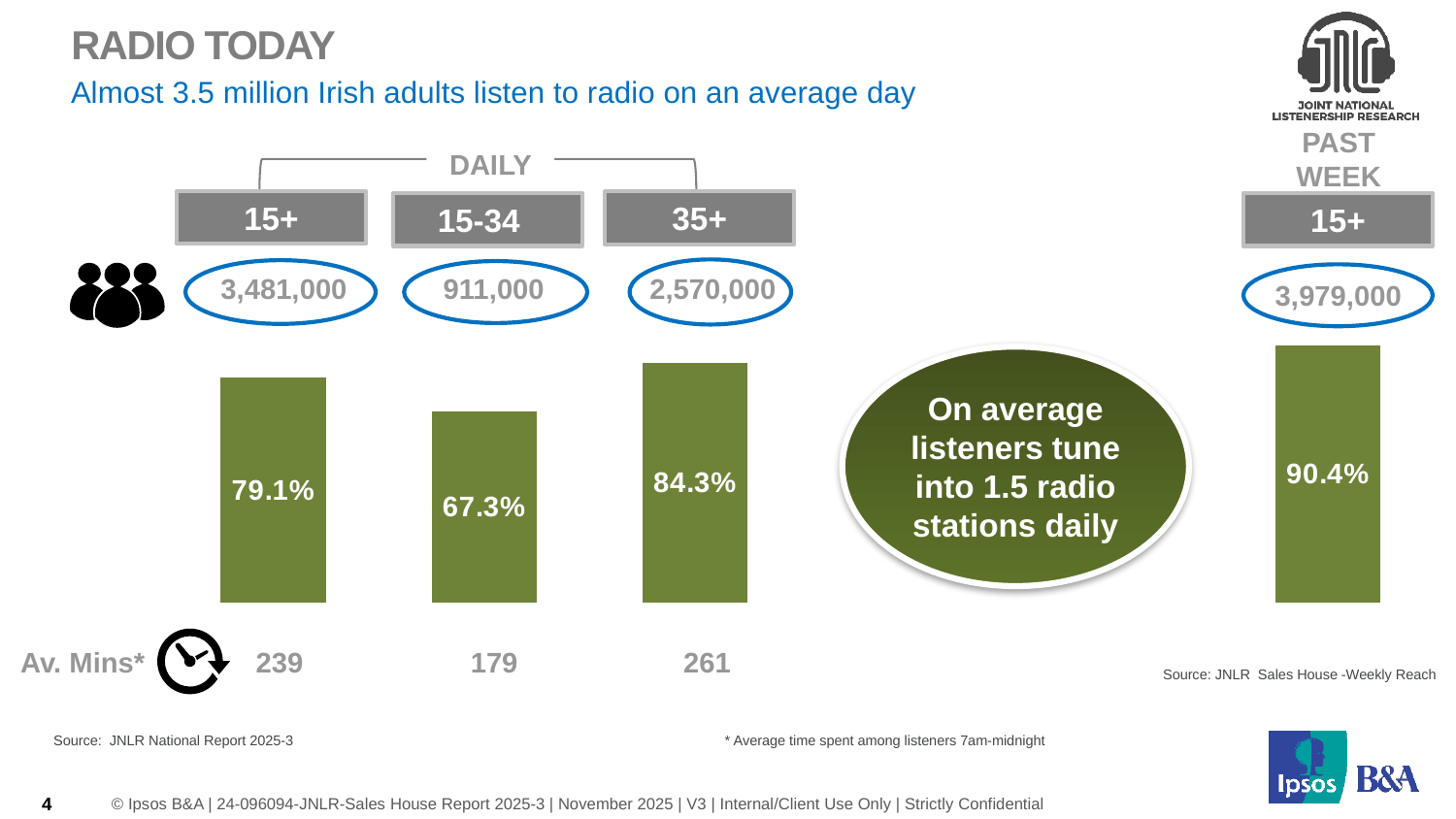
In the daily chart, which age group has the highest listening percentage? 35+ In the daily chart, what percentage of adults aged 15+ listen to radio? 79.1% In the daily chart, which age group has the lowest listening percentage? 15-34 In the daily chart, which is larger: the value for 15+ or the value for 15-34? 15+ In the daily chart, what is the difference in percentage points between the 35+ and 15-34 groups? 17.0 percentage points What is the average number of minutes (Av. Mins*) shown for the 35+ age group? 261 In the daily chart, what is the value shown for the 15-34 age group? 67.3% How many age-group bars are shown in the daily chart? 3 In the past week chart, what percentage is shown for adults aged 15+? 90.4% How many daily listeners are shown for the 15-34 age group? 911,000 In the daily chart, what is the value shown for the 35+ age group? 84.3% What kind of chart is used to show the daily listening percentages? Bar chart